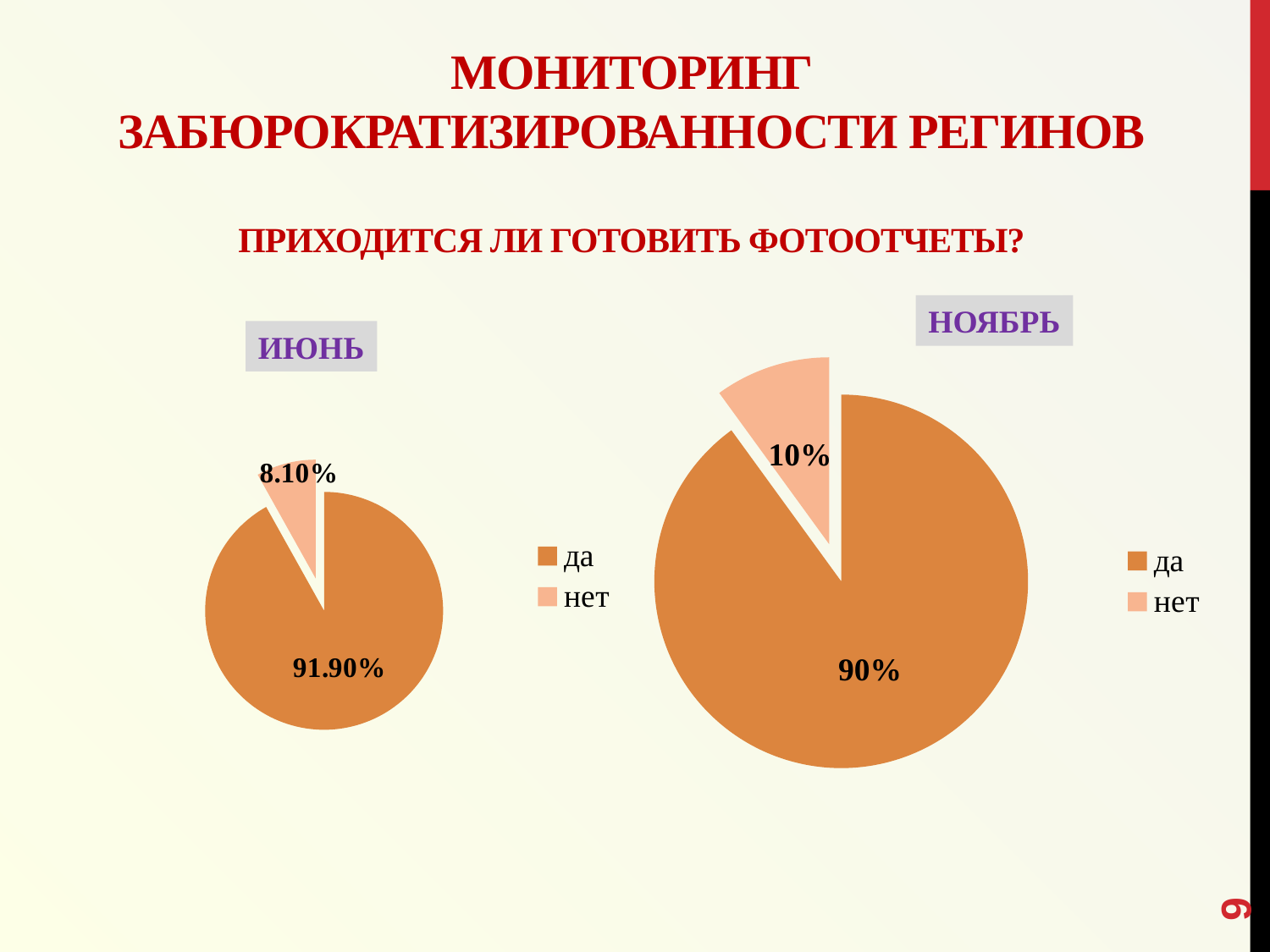
In the НОЯБРЬ pie chart, which category has the smallest slice? нет Which chart has the larger "нет" share, ИЮНЬ or НОЯБРЬ? НОЯБРЬ In the ИЮНЬ pie chart, which category has the largest slice? да In the НОЯБРЬ pie chart, what is the difference between the "да" and "нет" values? 80% In the ИЮНЬ pie chart, what is the value for "нет"? 8.10% In the НОЯБРЬ pie chart, what is the value for "да"? 90% How many categories does the legend of the НОЯБРЬ chart list? 2 In the ИЮНЬ pie chart, what is the difference between the "да" and "нет" values? 83.80% What type of chart is used for ИЮНЬ and НОЯБРЬ? Pie chart In the ИЮНЬ pie chart, what is the value for "да"? 91.90% What colour is the "нет" slice in the ИЮНЬ pie chart? Light peach/pink In the НОЯБРЬ pie chart, what is the value for "нет"? 10%